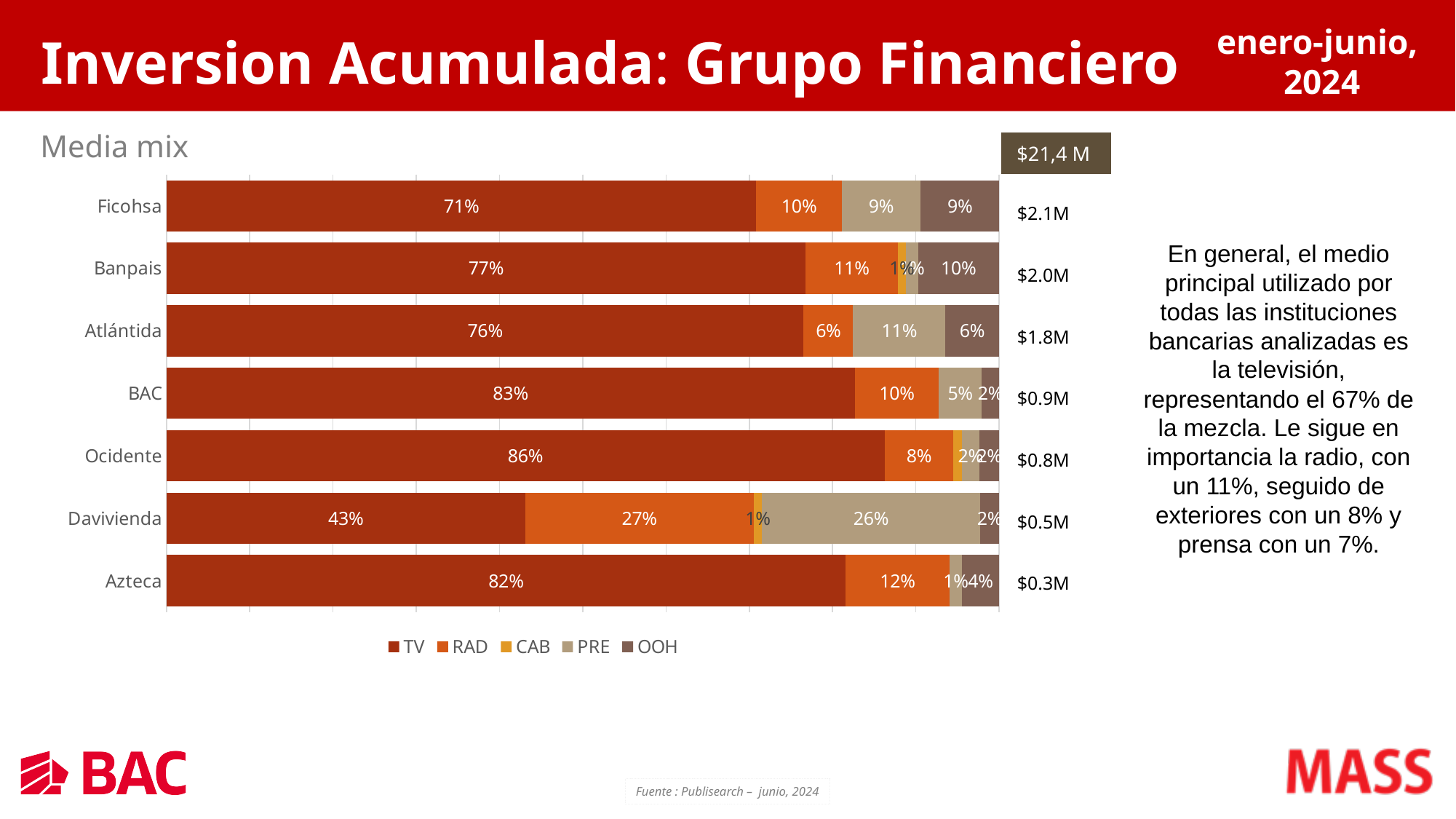
Which bank has the lowest TV share in the Media mix chart? Davivienda In the Media mix chart, what is the OOH share for Azteca? 4% How many series does the legend of the Media mix chart list? 5 In the Media mix chart, how many percentage points higher is Banpais's TV share than Ficohsa's TV share? 6 percentage points In the Media mix chart, what is the PRE share for Atlántida? 11% Which bank has the highest TV share in the Media mix chart? Ocidente In the Media mix chart, what is the RAD share for Davivienda? 27% In the Media mix chart, which has a larger PRE share: Atlántida or Ficohsa? Atlántida What kind of chart is the Media mix chart? Stacked bar chart In the Media mix chart, what percentage of Davivienda's media mix is TV? 43% How many banks are shown in the Media mix chart? 7 What investment amount is shown next to Ficohsa's bar in the Media mix chart? $2.1M